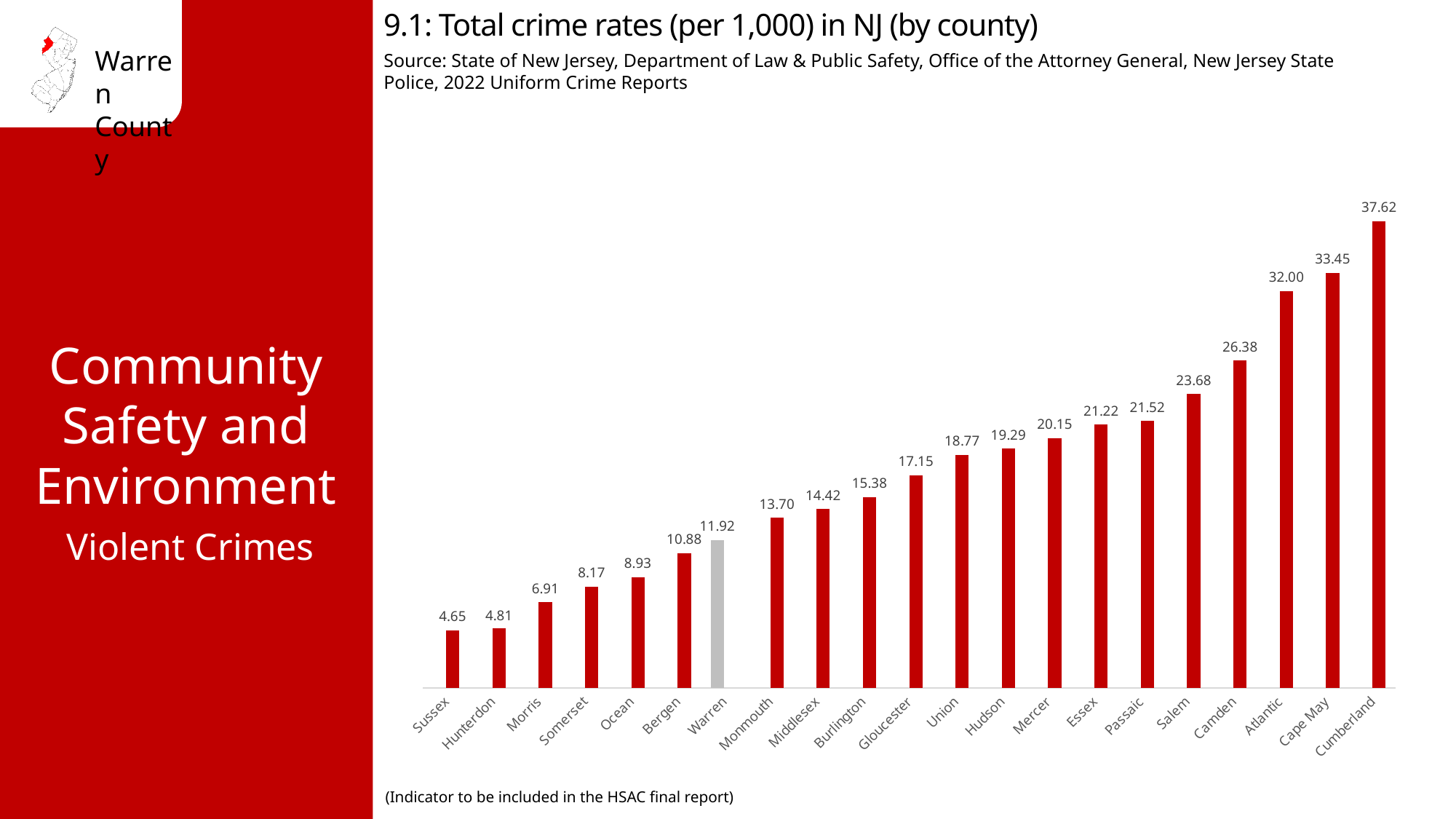
Which county has a higher total crime rate, Camden or Salem? Camden Which county has the lowest total crime rate? Sussex What is the total crime rate for Warren county? 11.92 Which county's bar is coloured grey instead of red? Warren Do the values rise or fall from left to right along the x axis? Rise What type of chart is shown on the slide? Bar chart What is the difference between the crime rates of Warren and Bergen? 1.04 What is the difference between the crime rates of Cumberland and Sussex? 32.97 Which county has the highest total crime rate? Cumberland What is the total crime rate for Hudson county? 19.29 How many counties are shown in the chart? 21 What is the total crime rate for Cape May county? 33.45